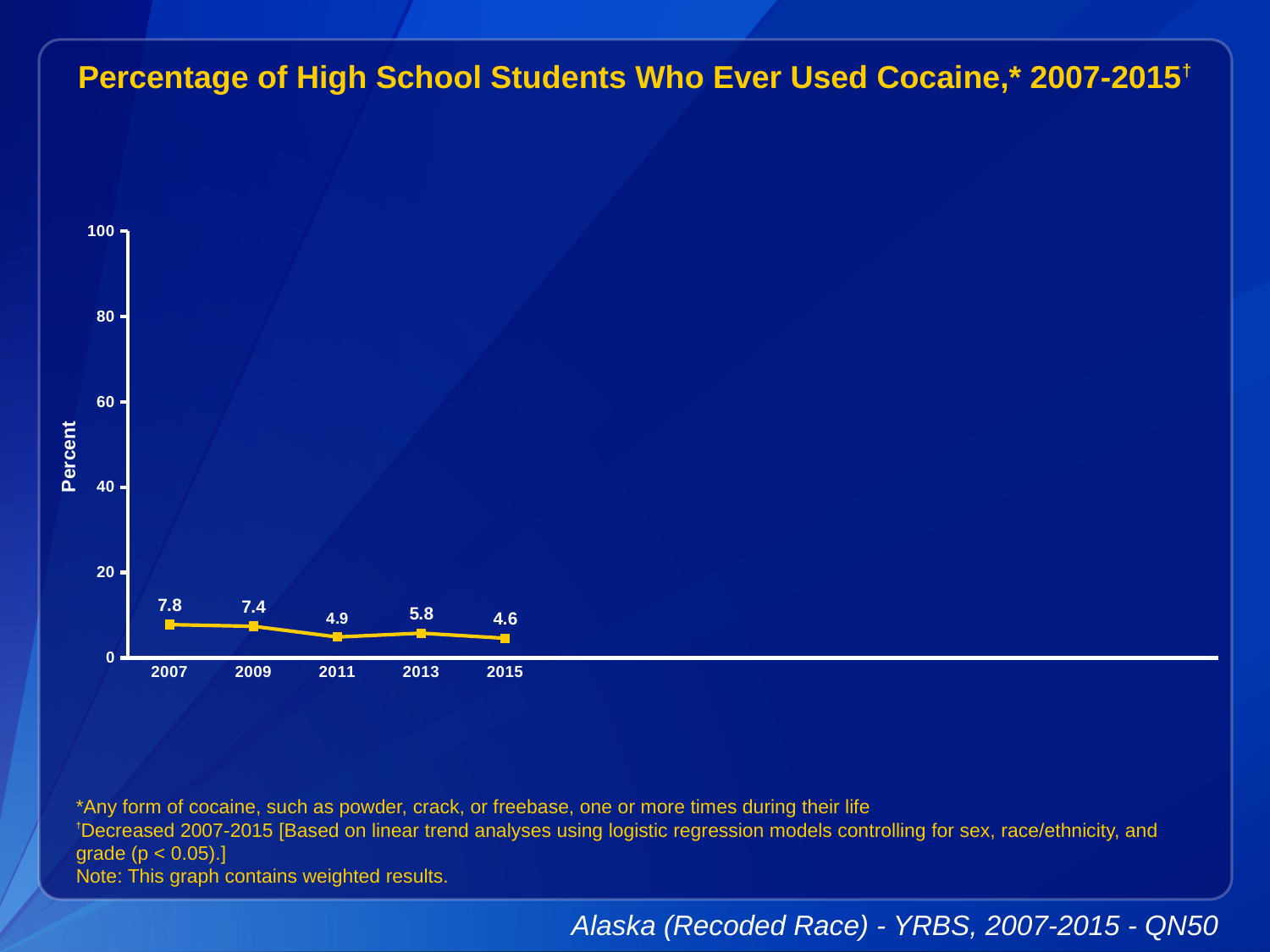
Is the value for 2007 greater or less than 20? less Which year has the highest percentage of students who ever used cocaine? 2007 Which year has the lowest percentage of students who ever used cocaine? 2015 What is the value plotted for 2015? 4.6 What is the difference between the 2007 value and the 2015 value? 3.2 What is the difference between the 2013 value and the 2011 value? 0.9 What kind of chart is shown on the slide? line chart Which year has a larger value, 2009 or 2013? 2009 How many years are plotted on the chart? 5 What is the value plotted for 2011? 4.9 What is the label on the y axis? Percent What percentage of high school students had ever used cocaine in 2007? 7.8